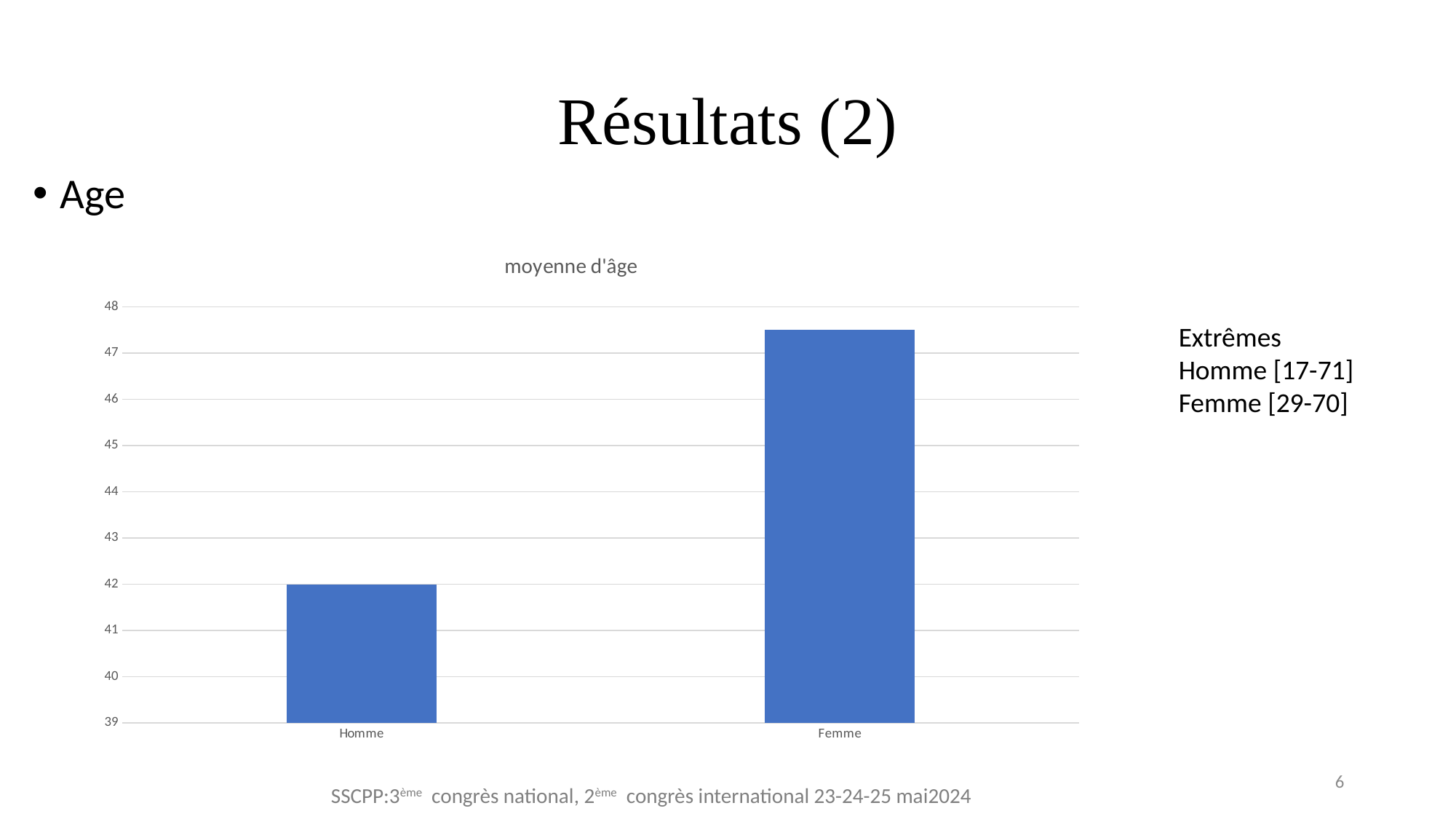
Which category has the lowest value in the chart? Homme Do the values rise or fall going from Homme to Femme along the x axis? rise How many categories are shown on the x axis of the chart? 2 Is the value for Homme greater or less than 45? less Is the value for Femme greater or less than 47? greater What is the lowest value shown on the y axis of the chart? 39 What is the value for Homme in the chart? 42 What is the title of the chart? moyenne d'âge Is the value for Femme greater or less than 48? less What type of chart is shown on the slide? bar chart Which category has the highest value in the chart? Femme Which is larger, the value for Homme or the value for Femme? Femme